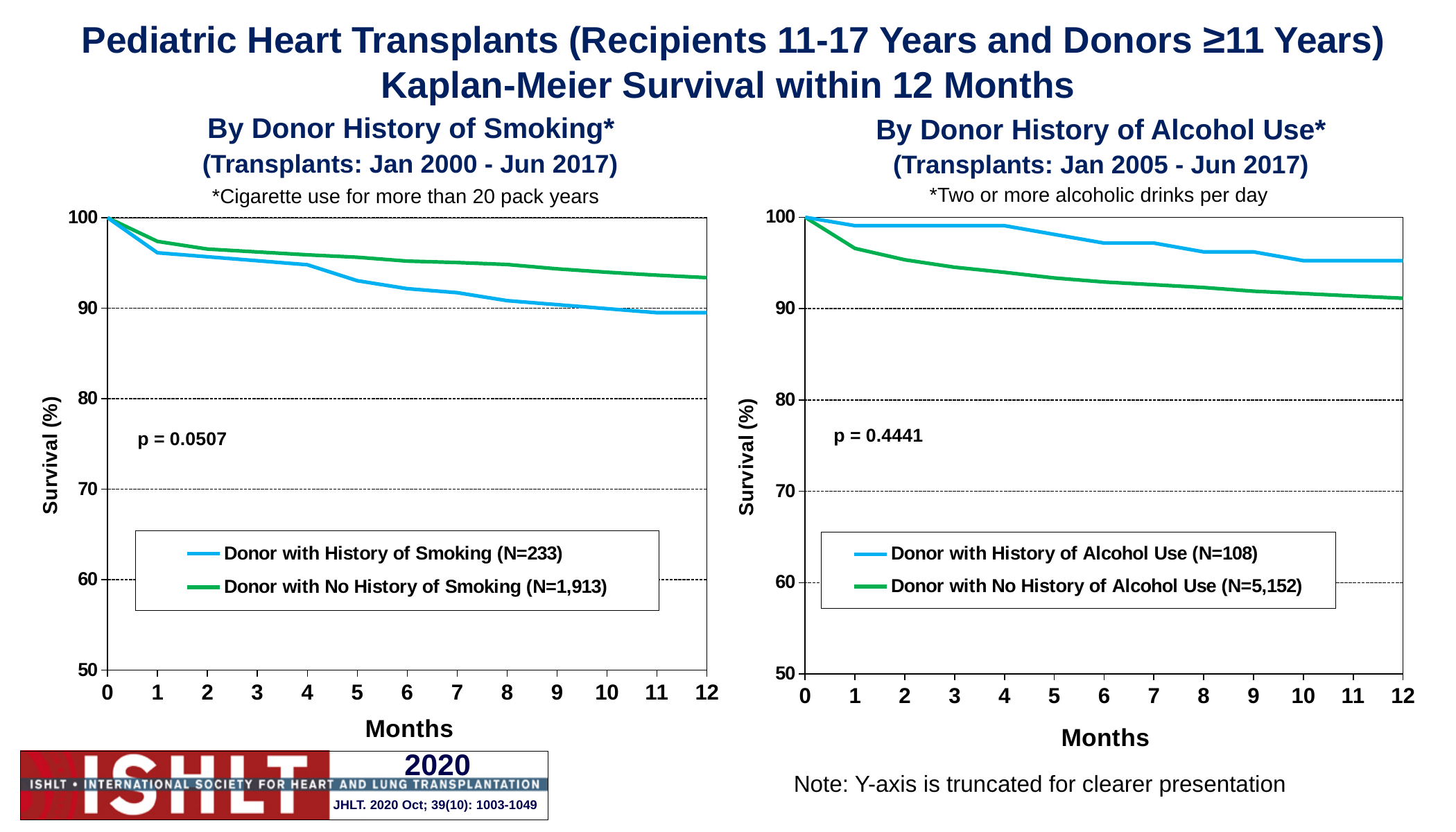
In the 'By Donor History of Smoking' chart, is the survival for Donor with No History of Smoking at 12 months greater or less than 90? greater In the 'By Donor History of Smoking' chart, which series has the higher survival at 12 months? Donor with No History of Smoking (N=1,913) How many series does the legend of the 'By Donor History of Smoking' chart list? 2 In the 'By Donor History of Alcohol Use' chart, what is the N for Donor with No History of Alcohol Use according to the legend? 5,152 In the 'By Donor History of Alcohol Use' chart, does survival for Donor with No History of Alcohol Use rise or fall from 0 to 12 months? Fall In the 'By Donor History of Alcohol Use' chart, which series has the higher survival at 12 months? Donor with History of Alcohol Use (N=108) In the 'By Donor History of Smoking' chart, is the survival for Donor with History of Smoking at 12 months greater or less than 90? less How many series does the legend of the 'By Donor History of Alcohol Use' chart list? 2 In the 'By Donor History of Alcohol Use' chart, what p-value is shown? p = 0.4441 In the 'By Donor History of Smoking' chart, what is the survival value for both series at 0 months? 100 What kind of chart is the 'By Donor History of Smoking' chart on the left? Line chart In the 'By Donor History of Smoking' chart, what p-value is shown? p = 0.0507